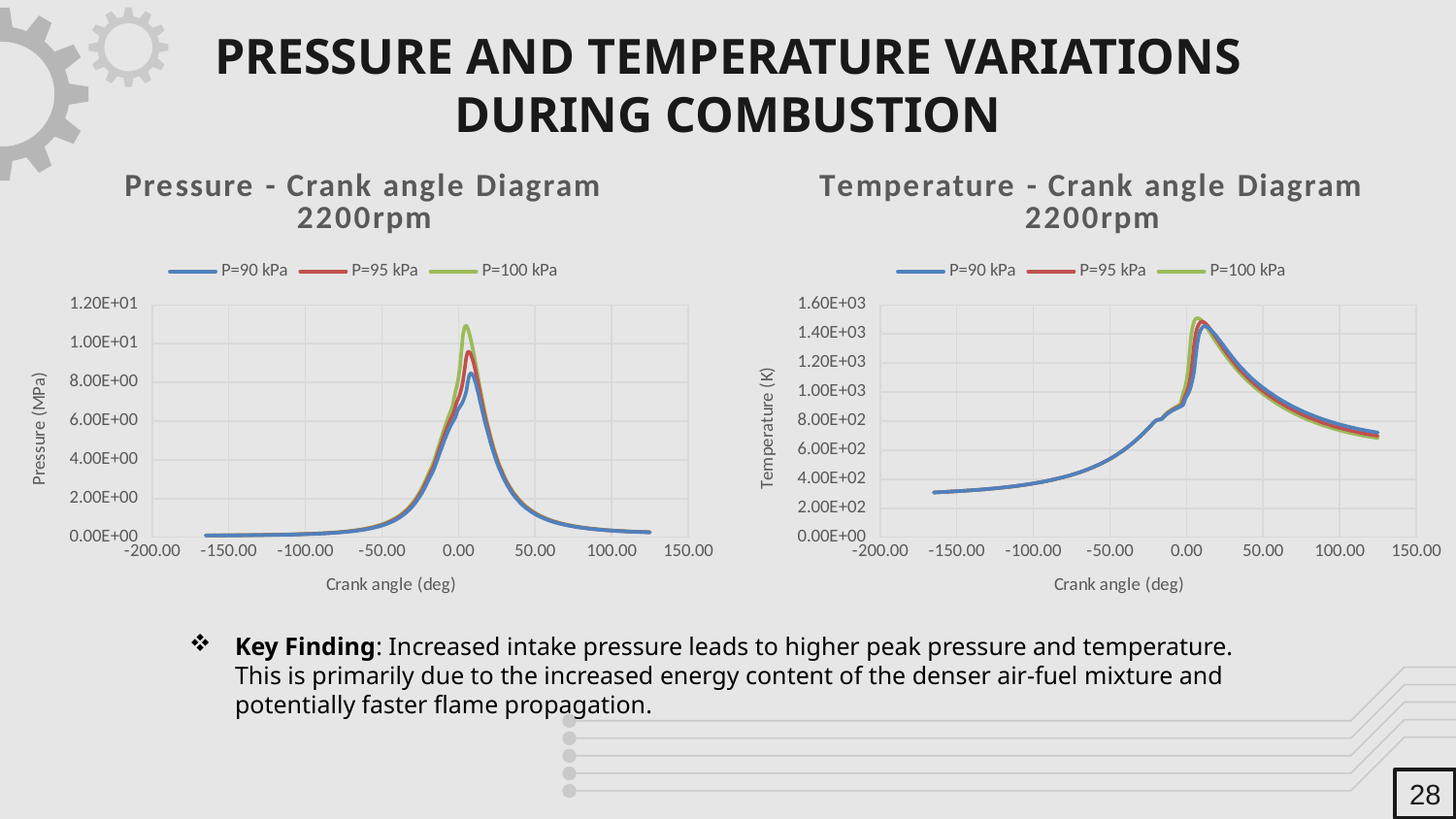
How many series does the legend of the Temperature - Crank angle Diagram 2200rpm list? 3 What are the legend entries of the Pressure - Crank angle Diagram 2200rpm? P=90 kPa, P=95 kPa, P=100 kPa In the Temperature - Crank angle Diagram 2200rpm, is the peak temperature for P=100 kPa greater or less than 1.20E+03? greater What is the y-axis title of the Temperature - Crank angle Diagram 2200rpm? Temperature (K) In the Pressure - Crank angle Diagram 2200rpm, which series has the lowest peak pressure? P=90 kPa What kind of chart is the Pressure - Crank angle Diagram 2200rpm? line chart In the Temperature - Crank angle Diagram 2200rpm, do the temperature values rise or fall between crank angles of 50.00 and 100.00? fall In the Pressure - Crank angle Diagram 2200rpm, is the peak value for P=90 kPa greater or less than 1.00E+01? less In the Pressure - Crank angle Diagram 2200rpm, which has the higher peak pressure, P=95 kPa or P=90 kPa? P=95 kPa In the Temperature - Crank angle Diagram 2200rpm, is the temperature at a crank angle of -150.00 greater or less than 4.00E+02? less In the Pressure - Crank angle Diagram 2200rpm, which series reaches the highest peak pressure? P=100 kPa